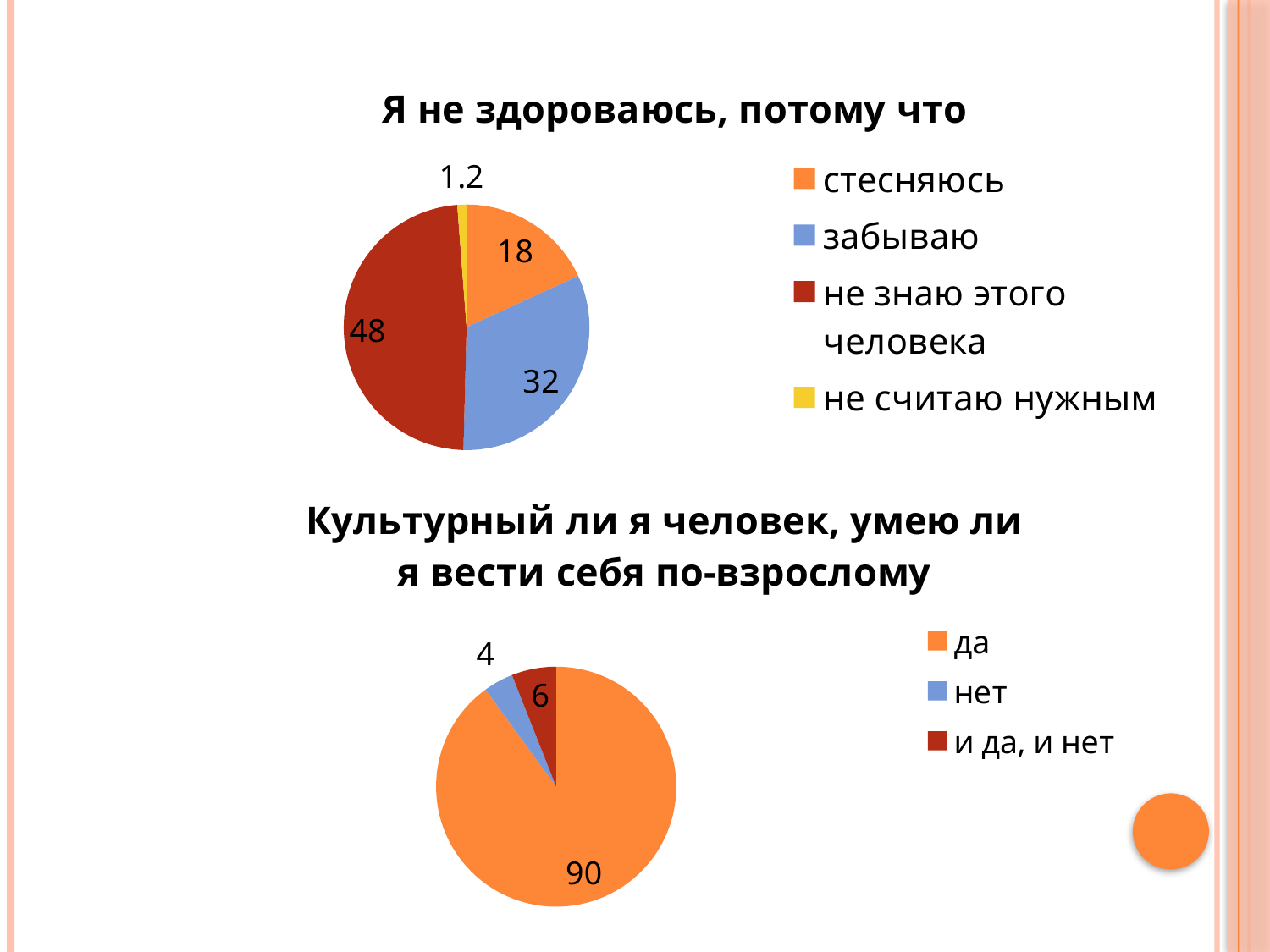
In the bottom chart 'Культурный ли я человек, умею ли я вести себя по-взрослому', what is the difference between the values for 'и да, и нет' and 'нет'? 2 In the top chart 'Я не здороваюсь, потому что', what is the value for 'забываю'? 32 In the bottom chart 'Культурный ли я человек, умею ли я вести себя по-взрослому', what is the value for 'и да, и нет'? 6 In the top chart 'Я не здороваюсь, потому что', what is the value for 'не считаю нужным'? 1.2 In the top chart 'Я не здороваюсь, потому что', which is larger: 'забываю' or 'стесняюсь'? забываю What type of chart is the bottom chart 'Культурный ли я человек, умею ли я вести себя по-взрослому'? pie chart How many categories does the top chart 'Я не здороваюсь, потому что' show? 4 In the top chart 'Я не здороваюсь, потому что', what is the difference between the values for 'не знаю этого человека' and 'стесняюсь'? 30 In the bottom chart 'Культурный ли я человек, умею ли я вести себя по-взрослому', which category has the smallest slice? нет In the top chart 'Я не здороваюсь, потому что', which category has the largest slice? не знаю этого человека In the top chart 'Я не здороваюсь, потому что', which category has the smallest slice? не считаю нужным In the bottom chart 'Культурный ли я человек, умею ли я вести себя по-взрослому', what is the value for 'да'? 90